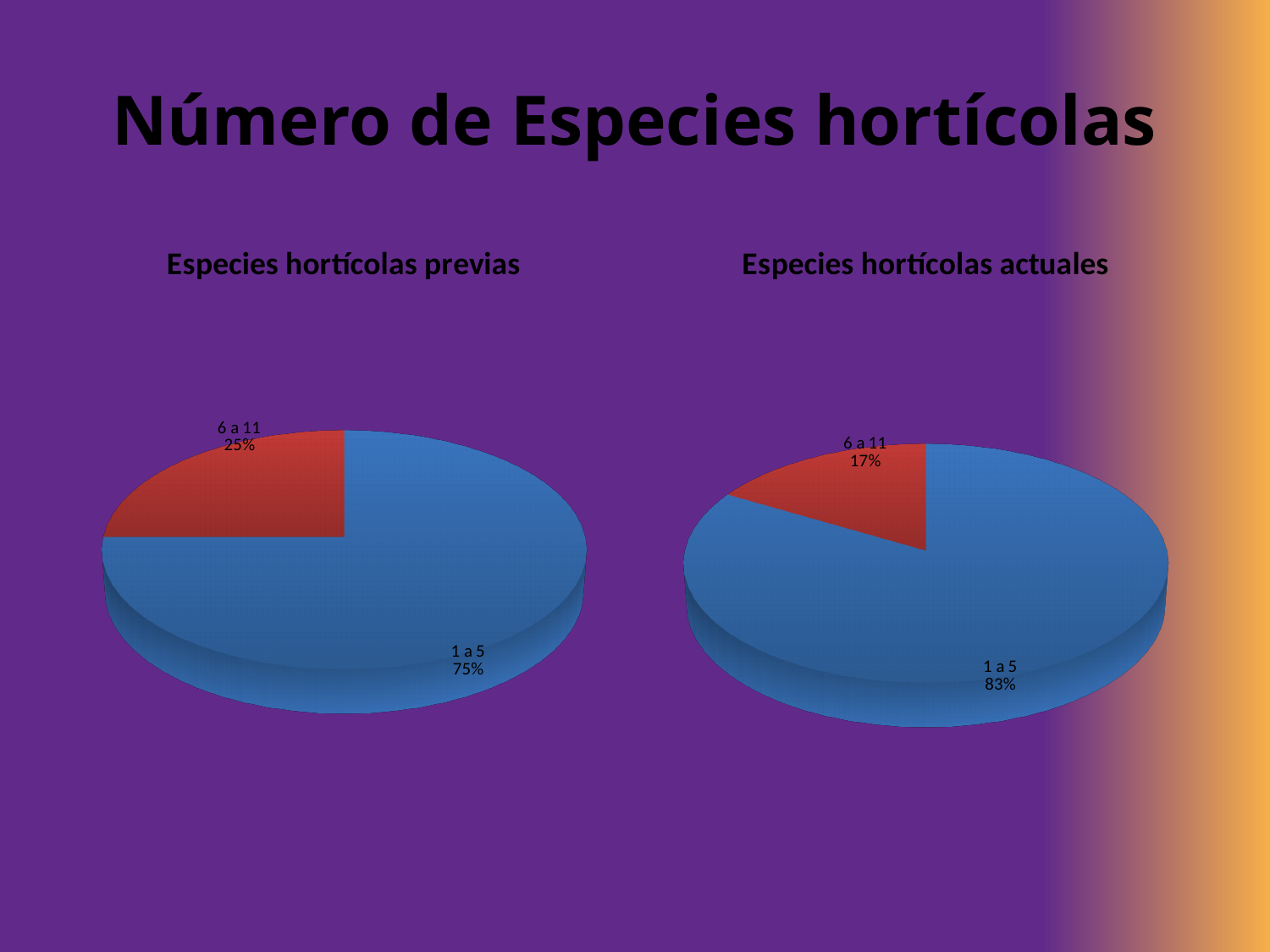
What kind of chart is 'Especies hortícolas previas'? Pie chart In the 'Especies hortícolas actuales' chart, what share does the '6 a 11' slice have? 17% How many slices does the 'Especies hortícolas actuales' chart have? 2 In the 'Especies hortícolas previas' chart, what share does the '1 a 5' slice have? 75% In the 'Especies hortícolas actuales' chart, what share does the '1 a 5' slice have? 83% Which chart has the larger '6 a 11' share, 'Especies hortícolas previas' or 'Especies hortícolas actuales'? Especies hortícolas previas In the 'Especies hortícolas actuales' chart, what is the difference between the '1 a 5' and '6 a 11' shares? 66% In the 'Especies hortícolas actuales' chart, which category has the smallest slice? 6 a 11 In the 'Especies hortícolas previas' chart, what is the difference between the '1 a 5' and '6 a 11' shares? 50% What is the title of the chart on the right side of the slide? Especies hortícolas actuales In the 'Especies hortícolas previas' chart, which category has the largest slice? 1 a 5